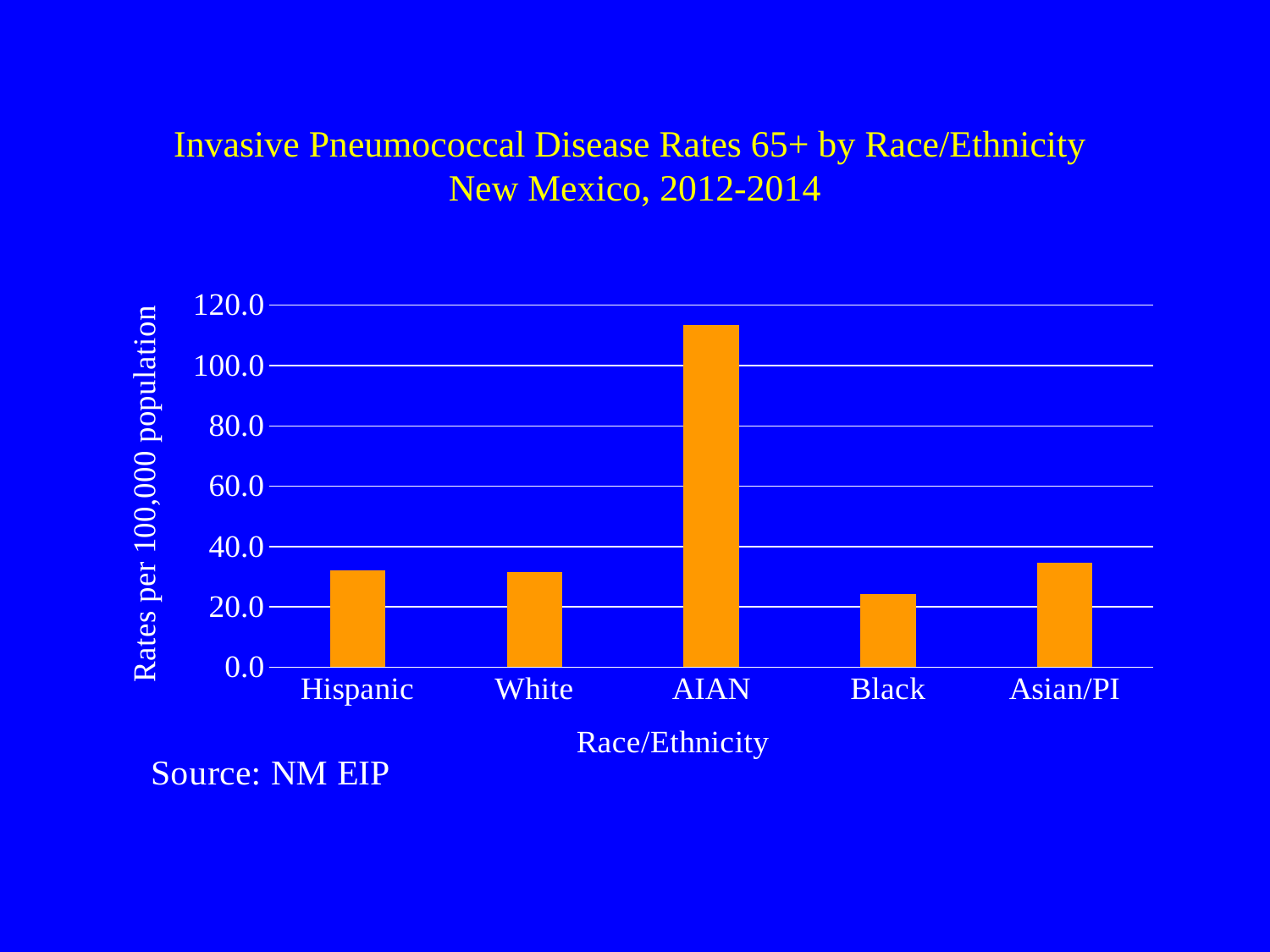
Is the value for AIAN greater or less than 100.0? greater How many race/ethnicity categories are plotted in the chart? 5 Is the value for White greater or less than 60.0? less Which has a larger rate, Asian/PI or Black? Asian/PI Is the value for Asian/PI greater or less than 20.0? greater Which has a larger rate, AIAN or Black? AIAN Which race/ethnicity group has the highest invasive pneumococcal disease rate? AIAN Which race/ethnicity group has the lowest invasive pneumococcal disease rate? Black What kind of chart is shown on the slide? bar chart What is the label of the y axis? Rates per 100,000 population